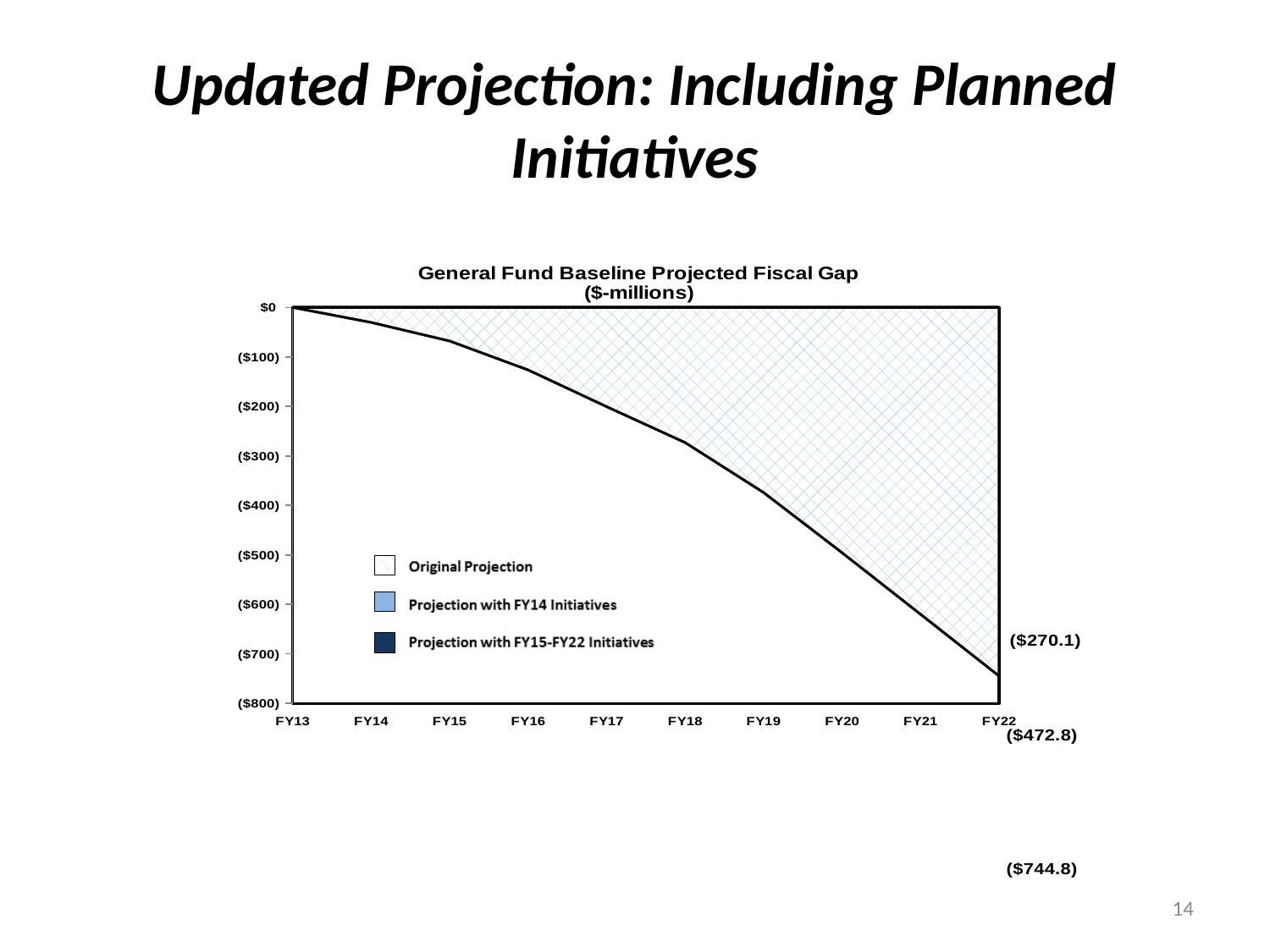
What kind of chart is shown on the slide? area chart What is the title of the chart? General Fund Baseline Projected Fiscal Gap ($-millions) How many fiscal years are shown along the x axis? 10 How many series does the chart's legend list? 3 In which fiscal year is the projected fiscal gap the largest (most negative)? FY22 What is the name of the third series listed in the legend? Projection with FY15-FY22 Initiatives Does the Original Projection line rise or fall from FY13 to FY22? fall Is the Original Projection value at FY20 greater or less than ($400)? less What is the value of the Original Projection at FY22? ($744.8) What is the value of the Original Projection at FY13? $0 Is the Original Projection value at FY14 greater or less than ($100)? greater Is the Original Projection value at FY16 greater or less than ($100)? less